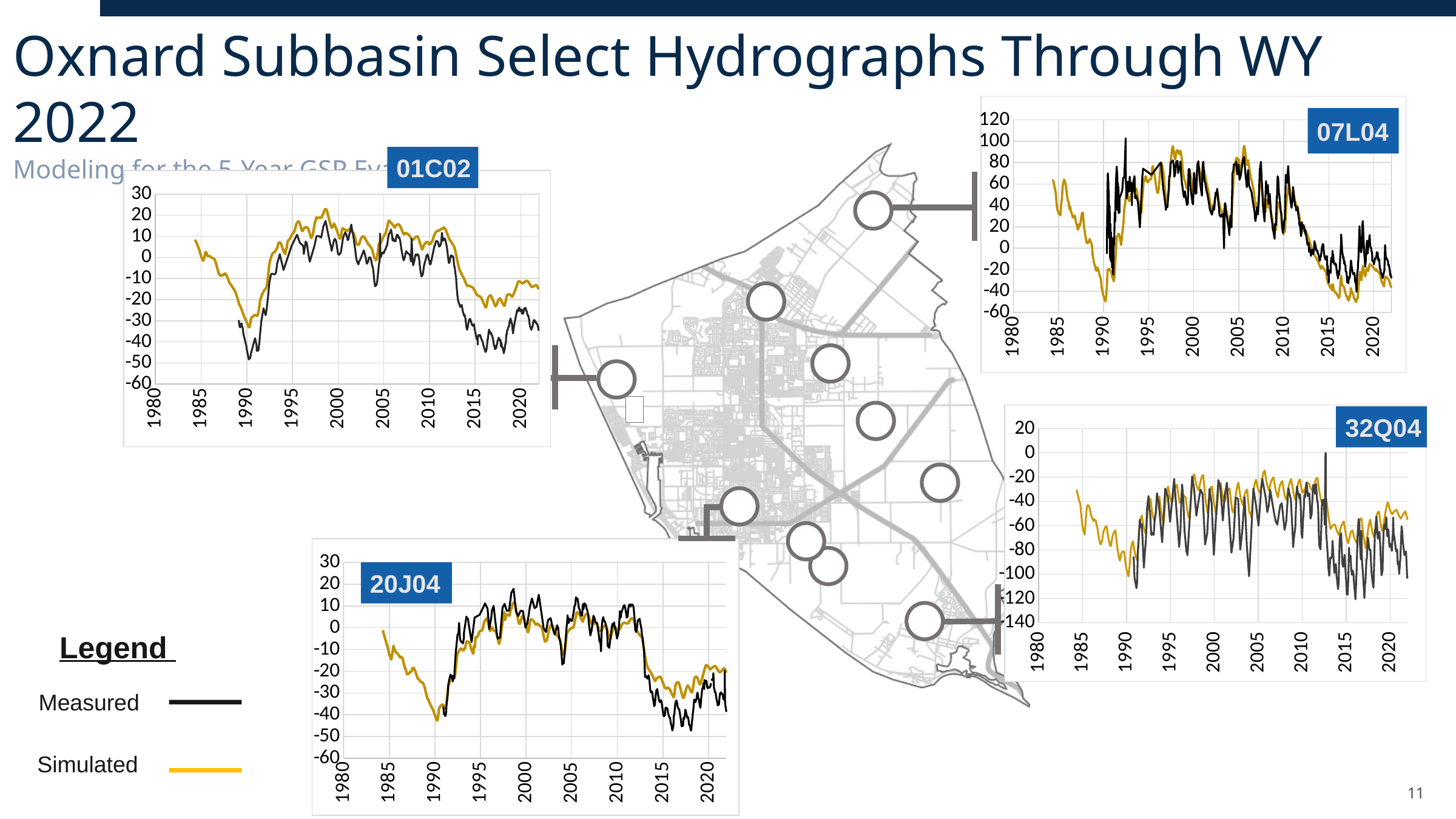
In the 07L04 chart, is the highest Measured value around 1991 greater or less than 80? greater In the 07L04 chart, do the Simulated values generally rise or fall between 2005 and 2020? fall In the legend, which colour represents the Simulated series? yellow How many series does the legend list? 2 What kind of chart is the 01C02 chart? line chart In the 07L04 chart, is the lowest Simulated value around 1990 greater or less than -40? less In the 01C02 chart, do the Measured values rise or fall between 2012 and 2016? fall In the 20J04 chart, is the lowest Measured value around 2017 greater or less than -40? less How many hydrograph charts are shown on the slide? 4 What is the label of the chart in the top right of the slide? 07L04